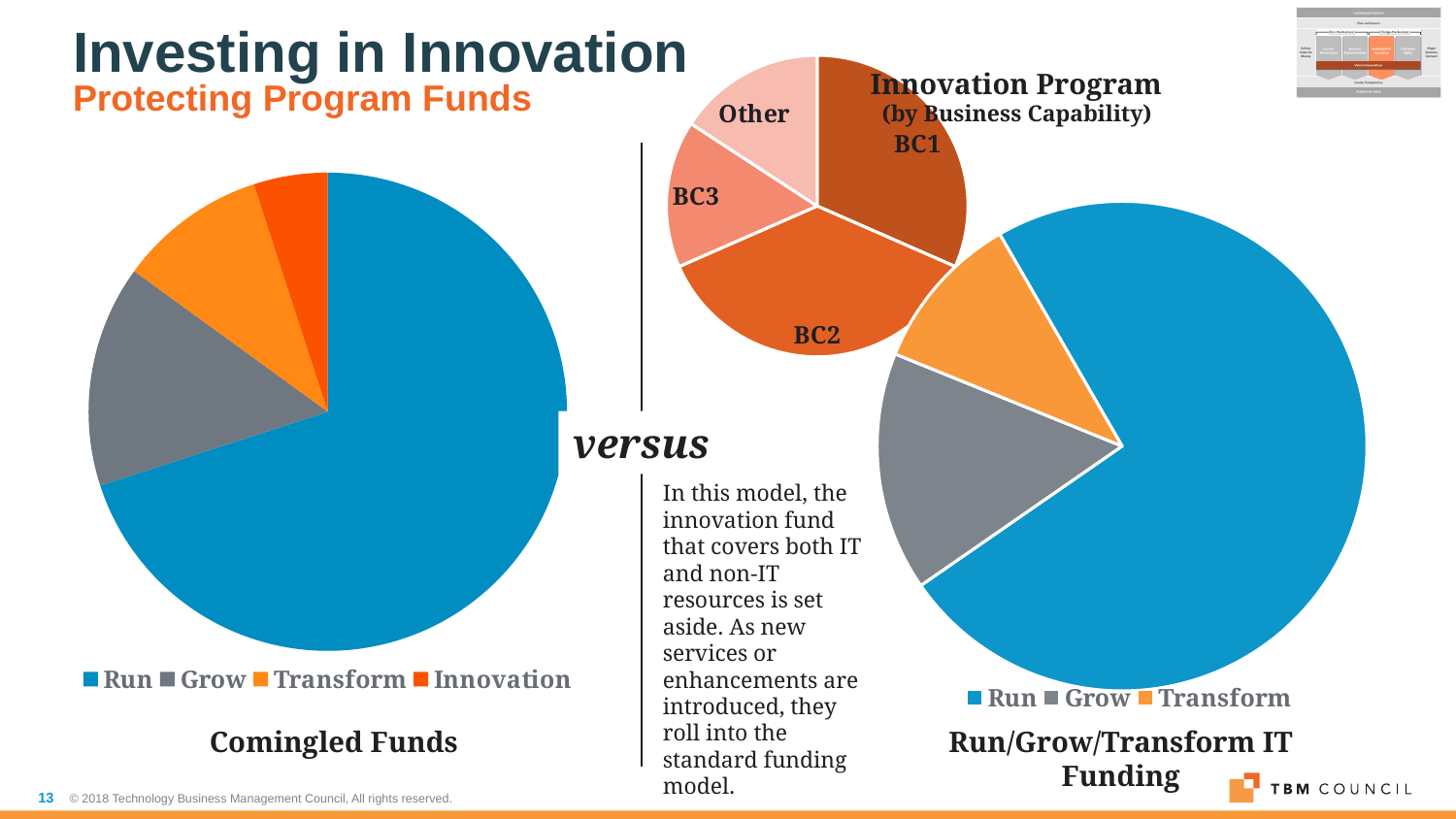
In the Innovation Program (by Business Capability) chart, which slice is larger, BC1 or BC3? BC1 In the Comingled Funds chart, which category has the smallest slice? Innovation How many entries does the legend of the Run/Grow/Transform IT Funding chart list? 3 In the Run/Grow/Transform IT Funding chart, which category has the largest slice? Run In the Run/Grow/Transform IT Funding chart, which category has the smallest slice? Transform In the Comingled Funds chart, which category has the largest slice? Run What kind of chart is the Comingled Funds chart? pie chart How many entries does the legend of the Comingled Funds chart list? 4 What kind of chart is the Run/Grow/Transform IT Funding chart? pie chart In the Comingled Funds chart, which slice is larger, Grow or Transform? Grow Which legend entry appears in the Comingled Funds chart but not in the Run/Grow/Transform IT Funding chart? Innovation How many slices does the Innovation Program (by Business Capability) chart have? 4